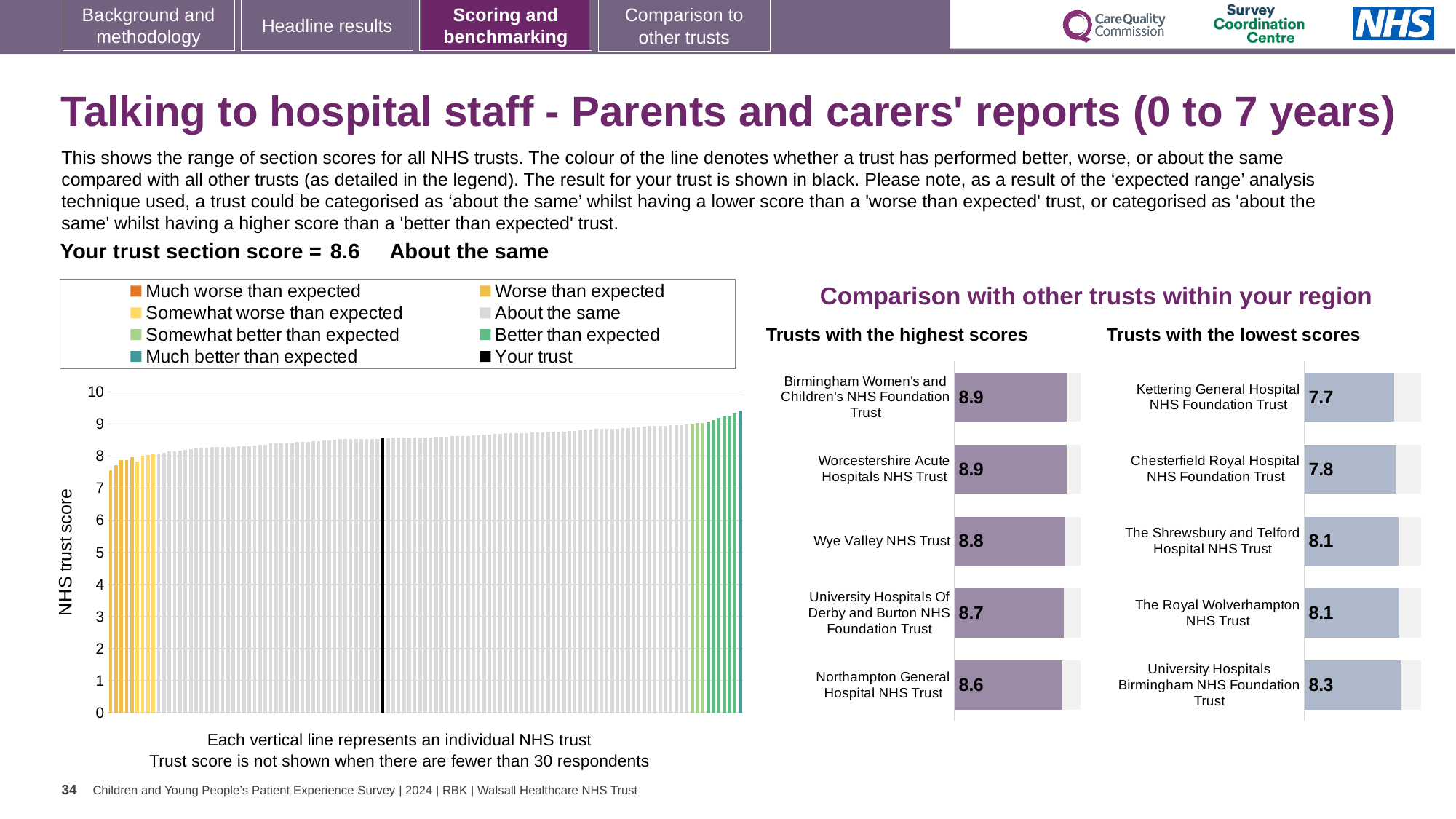
In the large chart on the left showing all NHS trusts, is the value for the black 'Your trust' line greater or less than 8? greater In the 'Trusts with the highest scores' chart, how many trusts are listed? 5 In the 'Trusts with the highest scores' chart, what is the score for Northampton General Hospital NHS Trust? 8.6 In the 'Trusts with the lowest scores' chart, what is the score for Kettering General Hospital NHS Foundation Trust? 7.7 In the 'Trusts with the lowest scores' chart, what is the score for Chesterfield Royal Hospital NHS Foundation Trust? 7.8 In the 'Trusts with the lowest scores' chart, which trust has the lowest score? Kettering General Hospital NHS Foundation Trust In the large chart on the left showing all NHS trusts, do the trust scores rise or fall from left to right? rise In the 'Trusts with the lowest scores' chart, which trust has the highest score shown? University Hospitals Birmingham NHS Foundation Trust How many entries does the legend above the large chart on the left list? 8 In the 'Trusts with the lowest scores' chart, what is the difference between the scores of University Hospitals Birmingham NHS Foundation Trust and Kettering General Hospital NHS Foundation Trust? 0.6 In the 'Trusts with the highest scores' chart, what is the score for Wye Valley NHS Trust? 8.8 In the 'Trusts with the highest scores' chart, which has the larger score: Wye Valley NHS Trust or University Hospitals Of Derby and Burton NHS Foundation Trust? Wye Valley NHS Trust